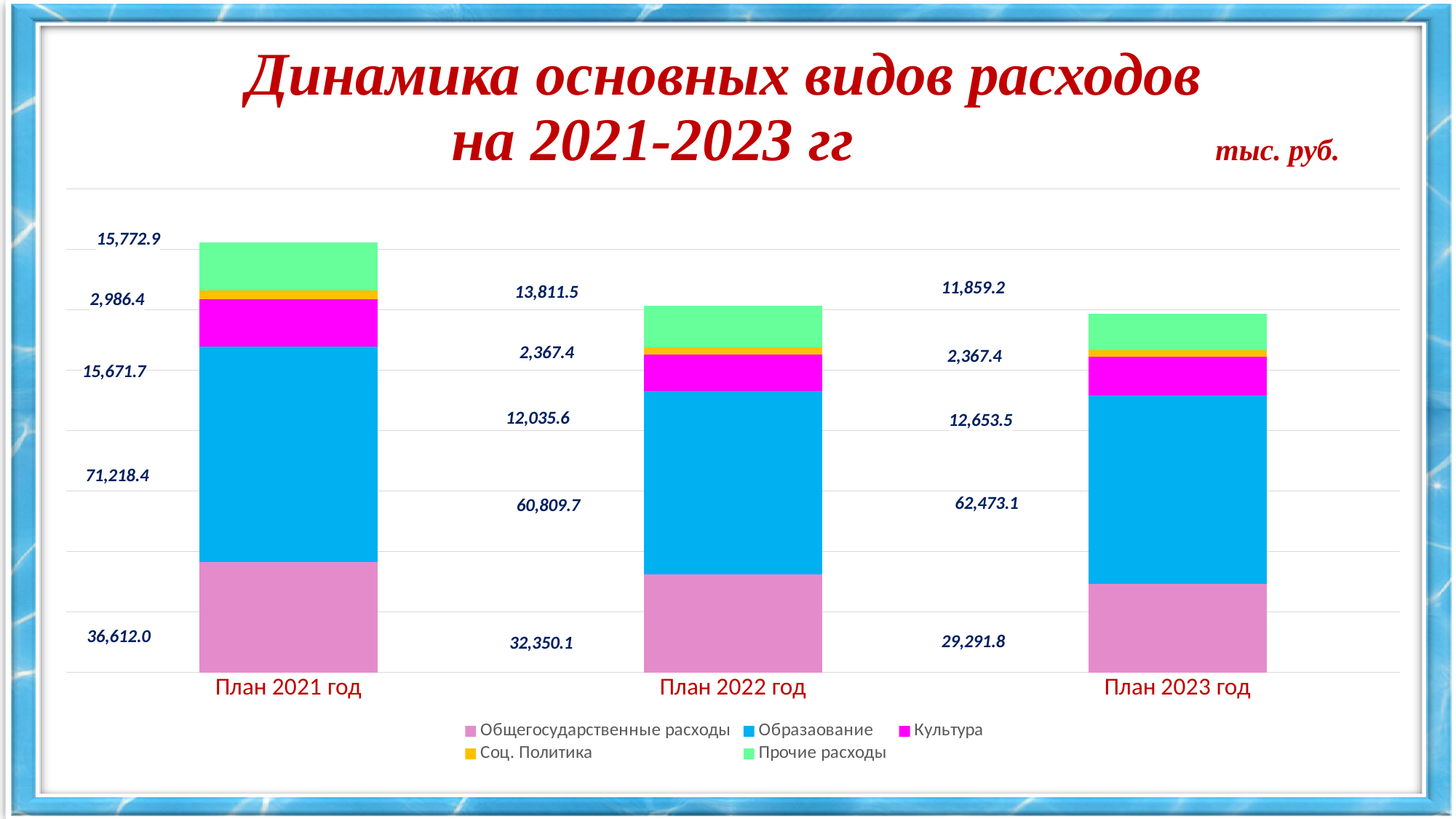
What is the value of Прочие расходы for План 2022 год? 13,811.5 What is the difference between Образаование in План 2021 год and План 2022 год? 10,408.7 How many categories (bars) are shown on the x axis? 3 What is the value of Образаование for План 2021 год? 71,218.4 What is the value of Общегосударственные расходы for План 2023 год? 29,291.8 What is the total of the stacked bar for План 2023 год? 118,645.0 How many series does the legend list? 5 Which year has the lowest value for Общегосударственные расходы? План 2023 год Which is larger: Образаование for План 2022 год or for План 2023 год? План 2023 год What is the value of Соц. Политика for План 2021 год? 2,986.4 What kind of chart is shown on the slide? stacked bar chart Which year has the highest value for Культура? План 2021 год